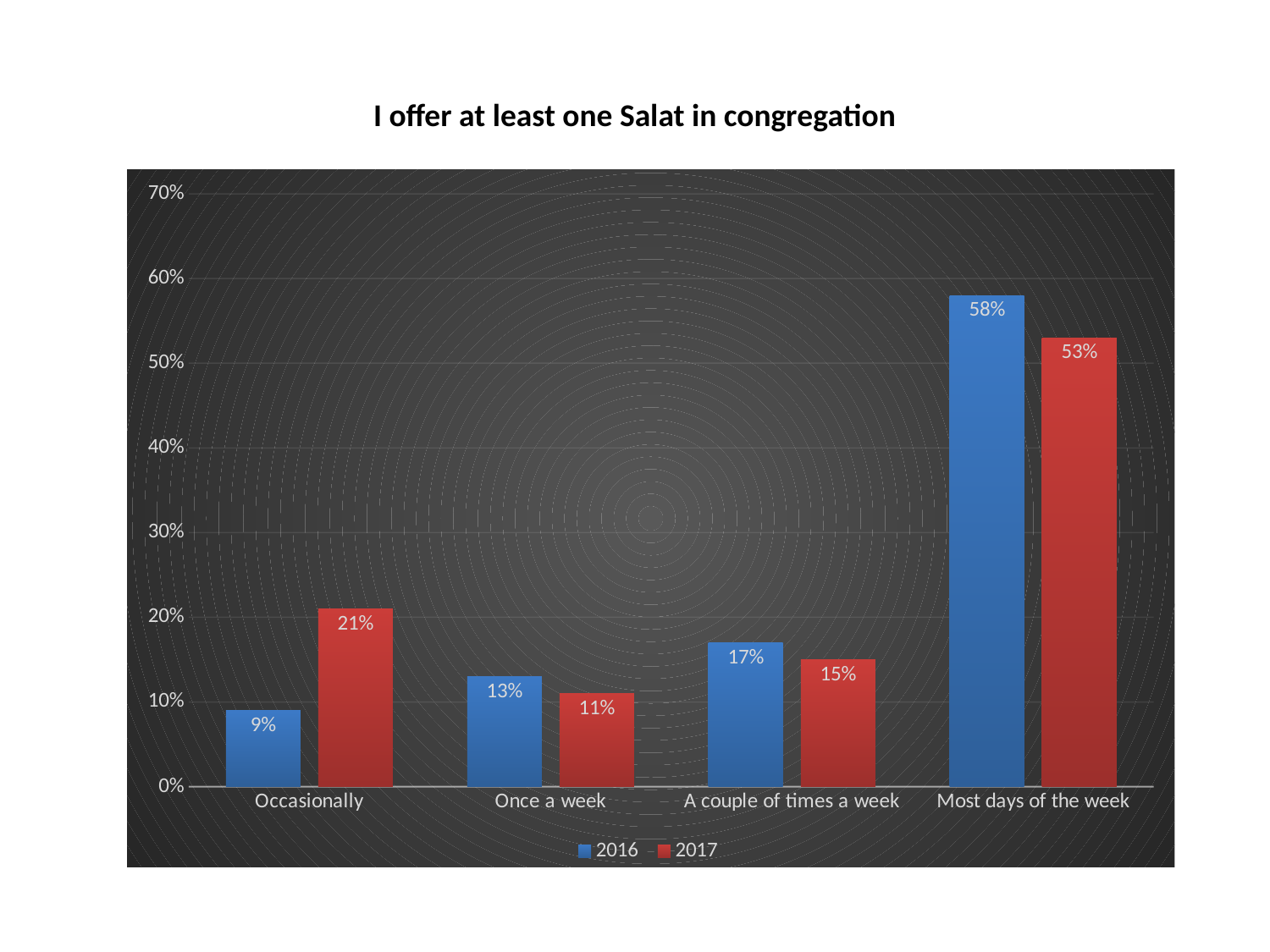
What is the title of the chart? I offer at least one Salat in congregation What is the difference between the 2016 and 2017 values for Most days of the week? 5% How many categories are shown on the x axis? 4 What is the 2017 value for Once a week? 11% What is the 2016 value for Occasionally? 9% What is the difference between the 2016 and 2017 values for Occasionally? 12% What is the 2017 value for Most days of the week? 53% Which category has the lowest 2017 value? Once a week How many series does the legend list? 2 Which category has the highest 2016 value? Most days of the week What kind of chart is shown on the slide? Bar chart Which is larger for A couple of times a week, the 2016 value or the 2017 value? 2016